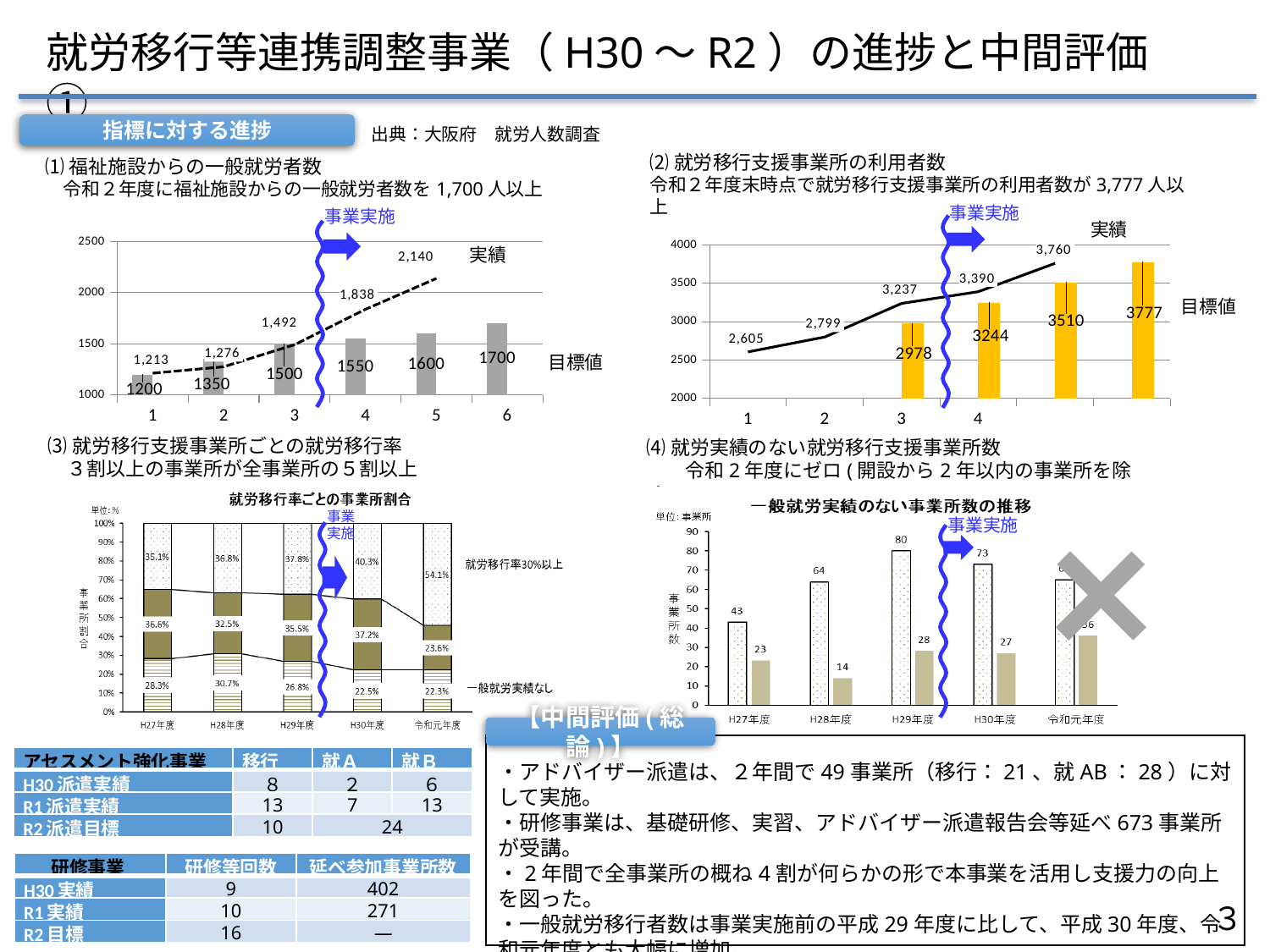
In the top-left chart (福祉施設からの一般就労者数), how many 目標値 bars are plotted? 6 In the top-left chart (福祉施設からの一般就労者数), what is the difference between the 実績 values at x = 4 and x = 3? 346 In the bottom-right chart (一般就労実績のない事業所数の推移), what is the difference between the two bars for H28年度? 50 In the bottom-right chart (一般就労実績のない事業所数の推移), what is the value of the taller bar for H29年度? 80 In the top-right chart (就労移行支援事業所の利用者数), what is the highest 目標値 bar value? 3777 In the top-right chart (就労移行支援事業所の利用者数), what is the 実績 value at x = 1? 2,605 In the bottom-left chart (就労移行率ごとの事業所割合), what is the 一般就労実績なし share for H28年度? 30.7% In the bottom-left chart (就労移行率ごとの事業所割合), which year has the highest 就労移行率30%以上 share? 令和元年度 In the top-left chart (福祉施設からの一般就労者数), what is the 実績 value at x = 5? 2,140 In the top-left chart (福祉施設からの一般就労者数), what is the 目標値 bar value at x = 6? 1700 In the bottom-left chart (就労移行率ごとの事業所割合), what is the 就労移行率30%以上 share for 令和元年度? 54.1% In the top-right chart (就労移行支援事業所の利用者数), does the 実績 line rise or fall from left to right? rise